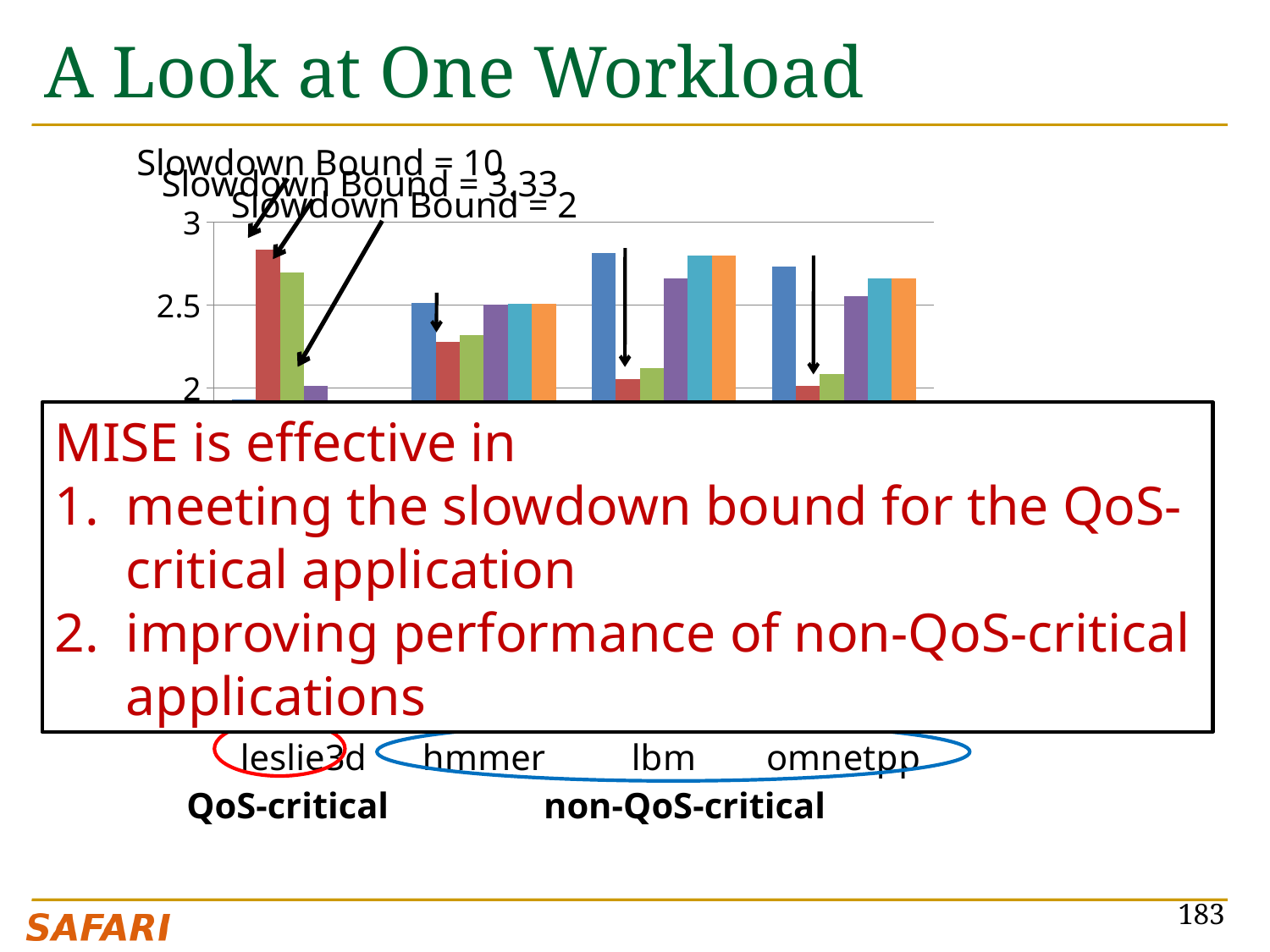
Is the shortest visible bar for omnetpp greater or less than 2.5? less Is the shortest visible bar for lbm greater or less than 2.5? less Does any bar in the chart reach the 3 tick on the y axis? No How many application categories are labelled on the x axis of the chart? 4 How many applications are grouped under the non-QoS-critical label? 3 Which application on the x axis is labelled as QoS-critical? leslie3d How many 'Slowdown Bound' annotations point at the chart? 3 What kind of chart is shown on the slide? bar chart